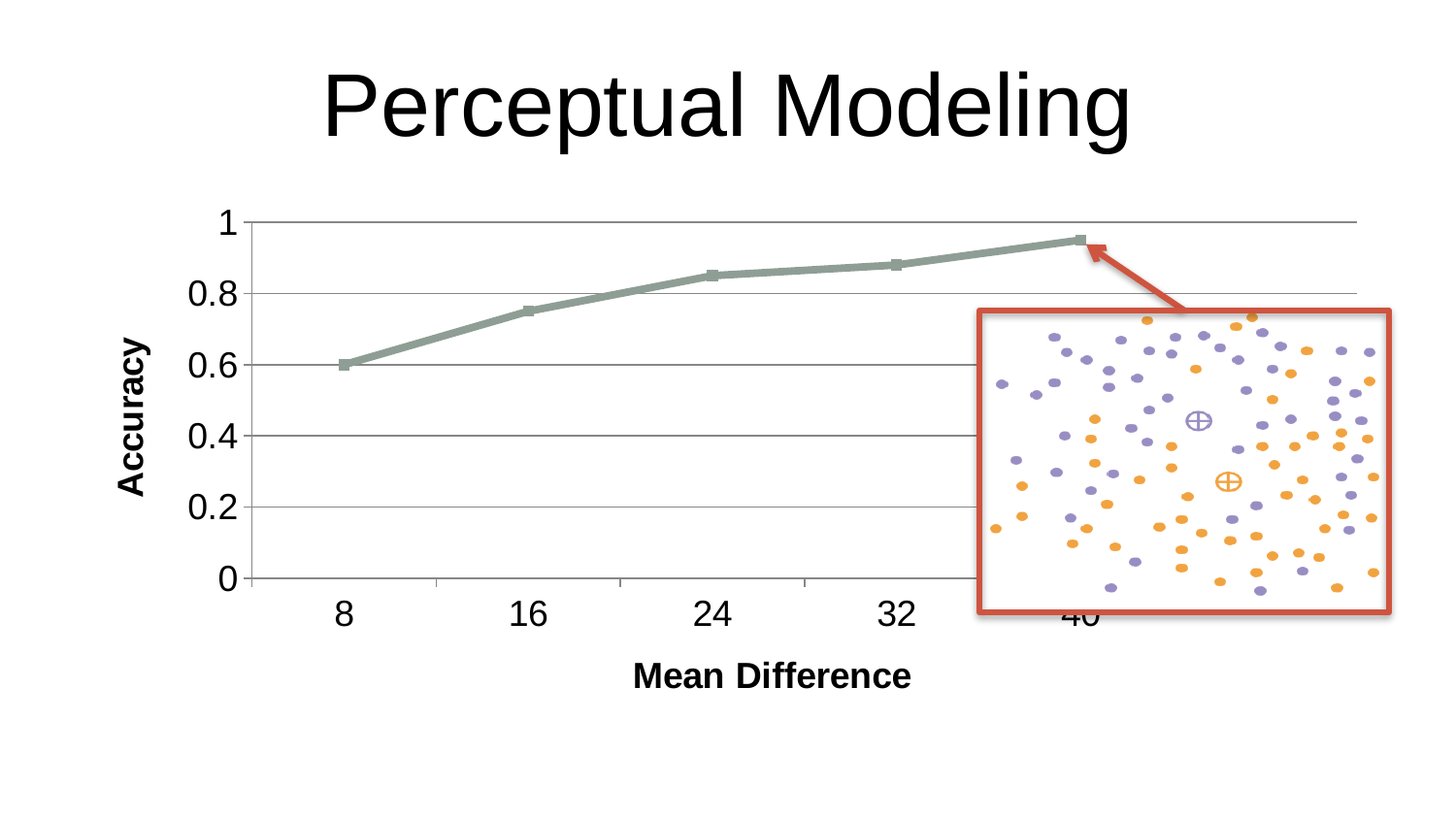
How many data points are plotted on the line? 5 At which mean difference is accuracy lowest? 8 What kind of chart is shown on the slide? line chart What is the accuracy at a mean difference of 8? 0.6 What is the label on the x axis? Mean Difference Is the accuracy at a mean difference of 40 greater or less than 0.8? greater Does accuracy rise or fall as mean difference increases along the x axis? rise Which has the larger accuracy, a mean difference of 8 or a mean difference of 32? 32 Is the accuracy at a mean difference of 16 greater or less than 0.8? less Is the accuracy at a mean difference of 24 greater or less than 0.8? greater At which mean difference is accuracy highest? 40 What is the label on the y axis? Accuracy